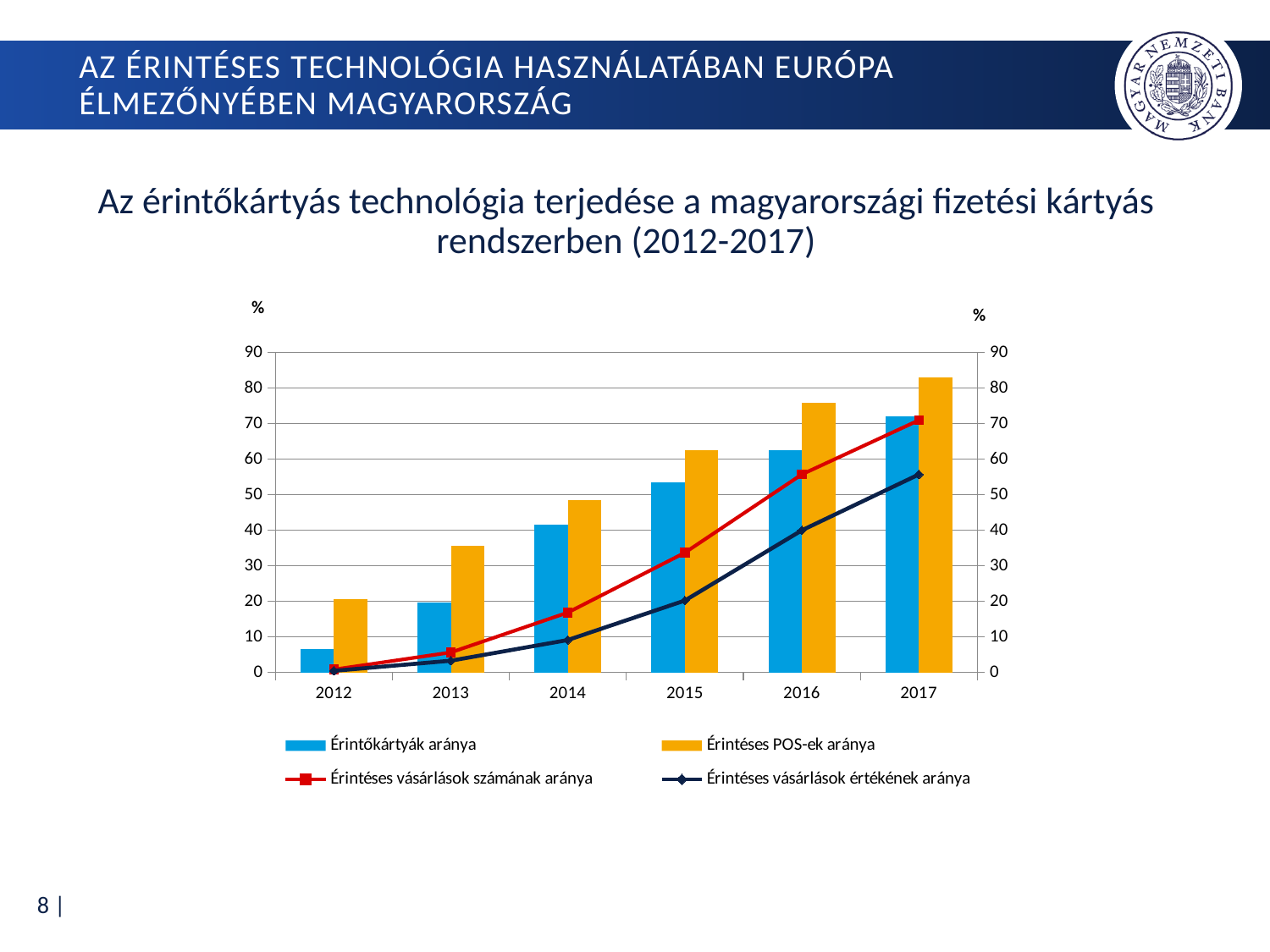
In 2013, which is larger: Érintőkártyák aránya or Érintéses POS-ek aránya? Érintéses POS-ek aránya Does the Érintéses vásárlások számának aránya line rise or fall from 2012 to 2017? rise How many series does the legend list? 4 Is the value for Érintéses POS-ek aránya in 2017 greater or less than 80? greater What kind of chart is this? A combined bar and line chart What colour are the bars for Érintéses POS-ek aránya? Orange Which year has the lowest value for Érintőkártyák aránya? 2012 Is the value for Érintéses vásárlások számának aránya in 2015 greater or less than 30? greater How many years are shown on the x axis? 6 Is the value for Érintőkártyák aránya in 2014 greater or less than 40? greater Which year has the highest value for Érintéses POS-ek aránya? 2017